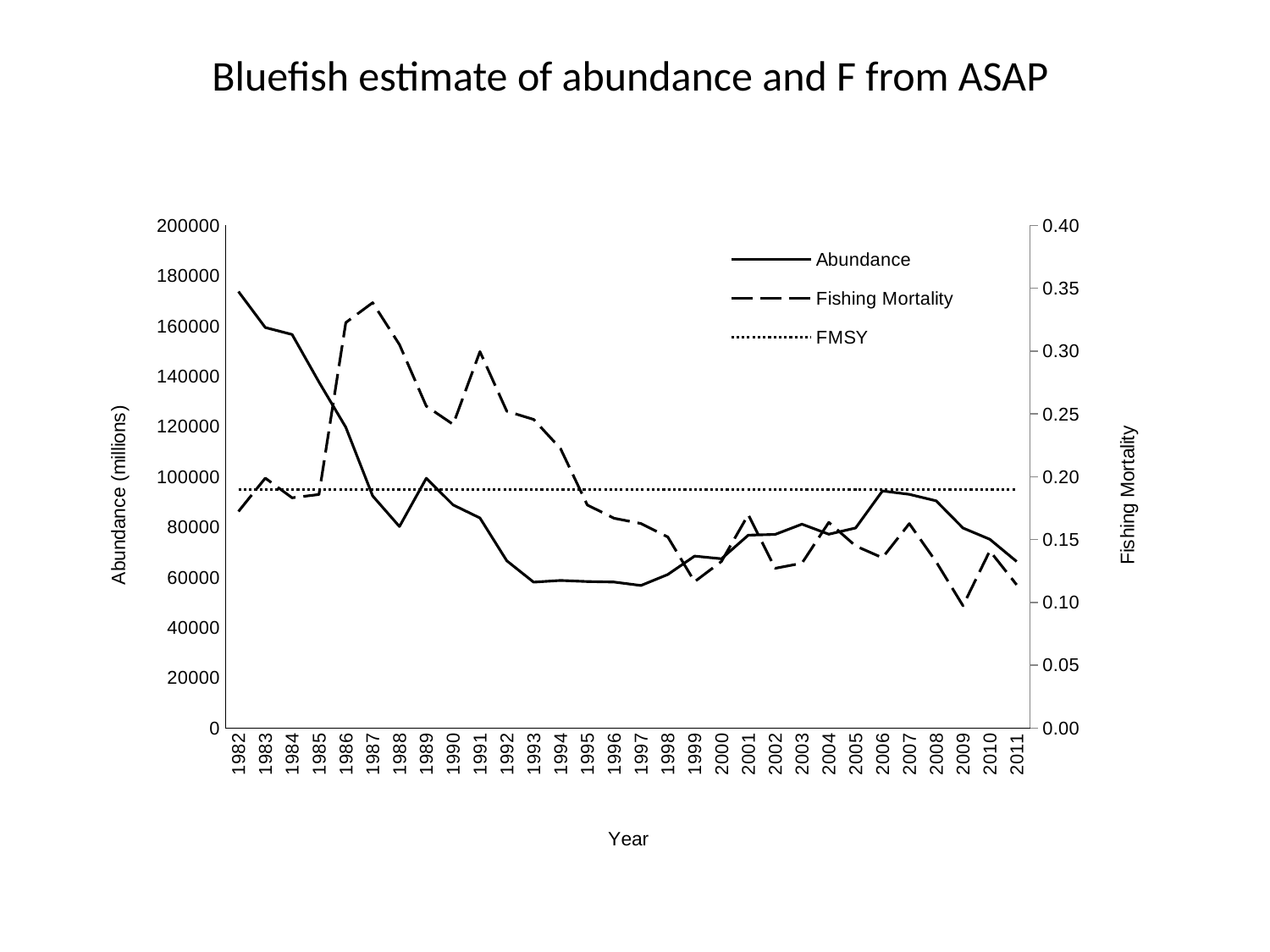
Which year has the larger Abundance, 1982 or 2011? 1982 In which year is Fishing Mortality highest? 1987 Is the Abundance value for 1982 greater or less than 160000? greater How many years are plotted along the x axis? 30 Does Abundance rise or fall from 1982 to 1993? fall What is the title of the chart? Bluefish estimate of abundance and F from ASAP In which year is Abundance highest? 1982 How many series does the legend list? 3 Is the Fishing Mortality value for 1987 greater or less than 0.30? greater In which year is Fishing Mortality lowest? 2009 What kind of chart is shown on the slide? line chart Is the Abundance value for 1993 greater or less than 80000? less